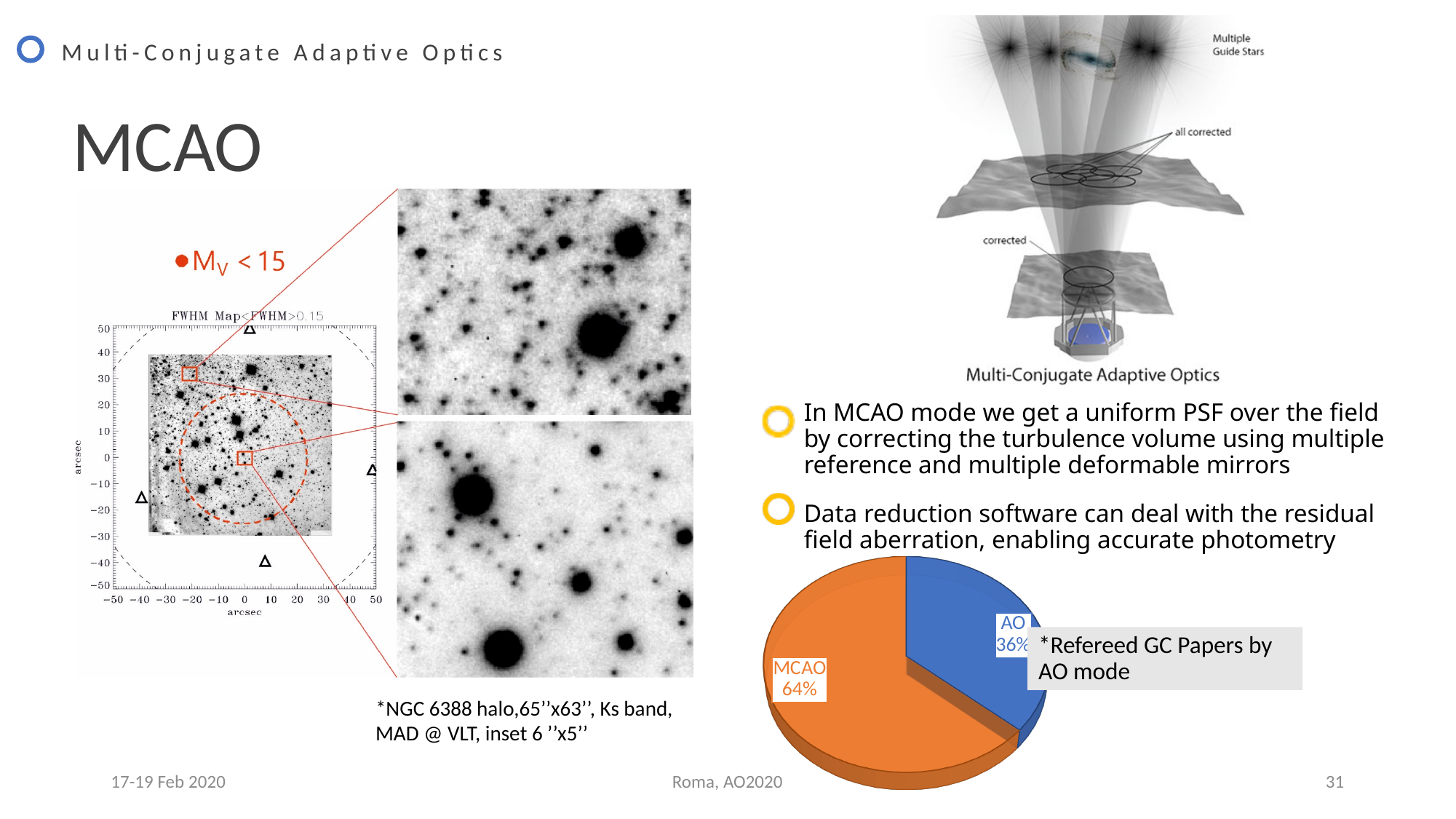
Which slice of the pie chart is the largest? MCAO What does the caption next to the pie chart say the chart represents? Refereed GC Papers by AO mode In the pie chart, which is larger: the MCAO share or the AO share? MCAO In the pie chart, by how many percentage points does the MCAO share exceed the AO share? 28% How many slices does the pie chart have? 2 In the pie chart, what share of refereed GC papers is attributed to MCAO mode? 64% What kind of chart is shown at the bottom right of the slide? pie chart In the pie chart, what share of refereed GC papers is attributed to AO mode? 36% Which slice of the pie chart is the smallest? AO What colour is the MCAO slice in the pie chart? orange